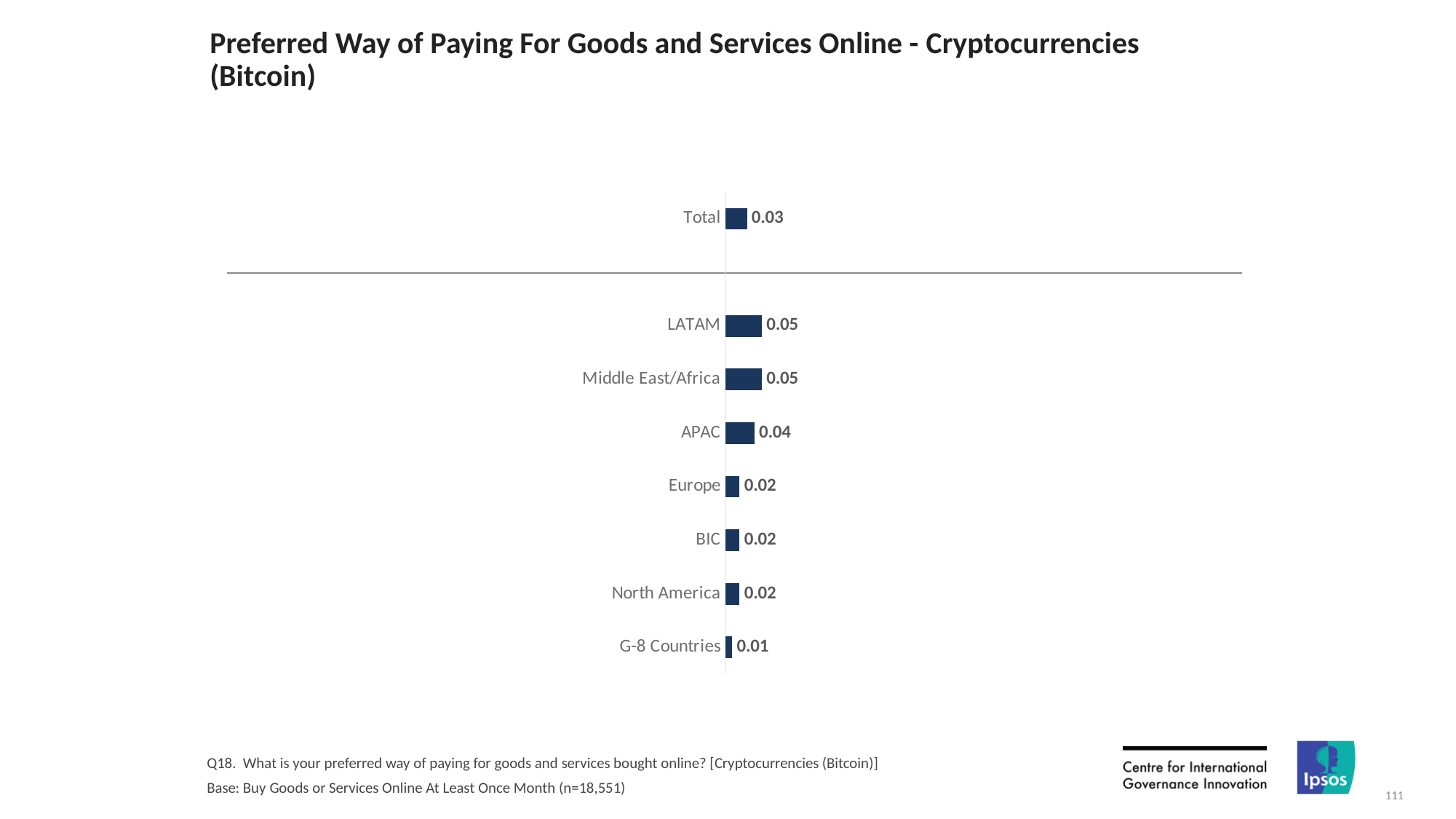
Which is larger, the value for APAC or the value for North America? APAC Which is larger, the value for Total or the value for LATAM? LATAM What is the title of the chart? Preferred Way of Paying For Goods and Services Online - Cryptocurrencies (Bitcoin) What is the value for APAC? 0.04 What is the difference between the values for APAC and G-8 Countries? 0.03 What is the value for G-8 Countries? 0.01 How many categories are plotted in the chart? 8 What is the difference between the values for LATAM and Europe? 0.03 What is the value for Middle East/Africa? 0.05 What is the value for Total? 0.03 What kind of chart is shown on the slide? Bar chart Which category has the lowest value? G-8 Countries